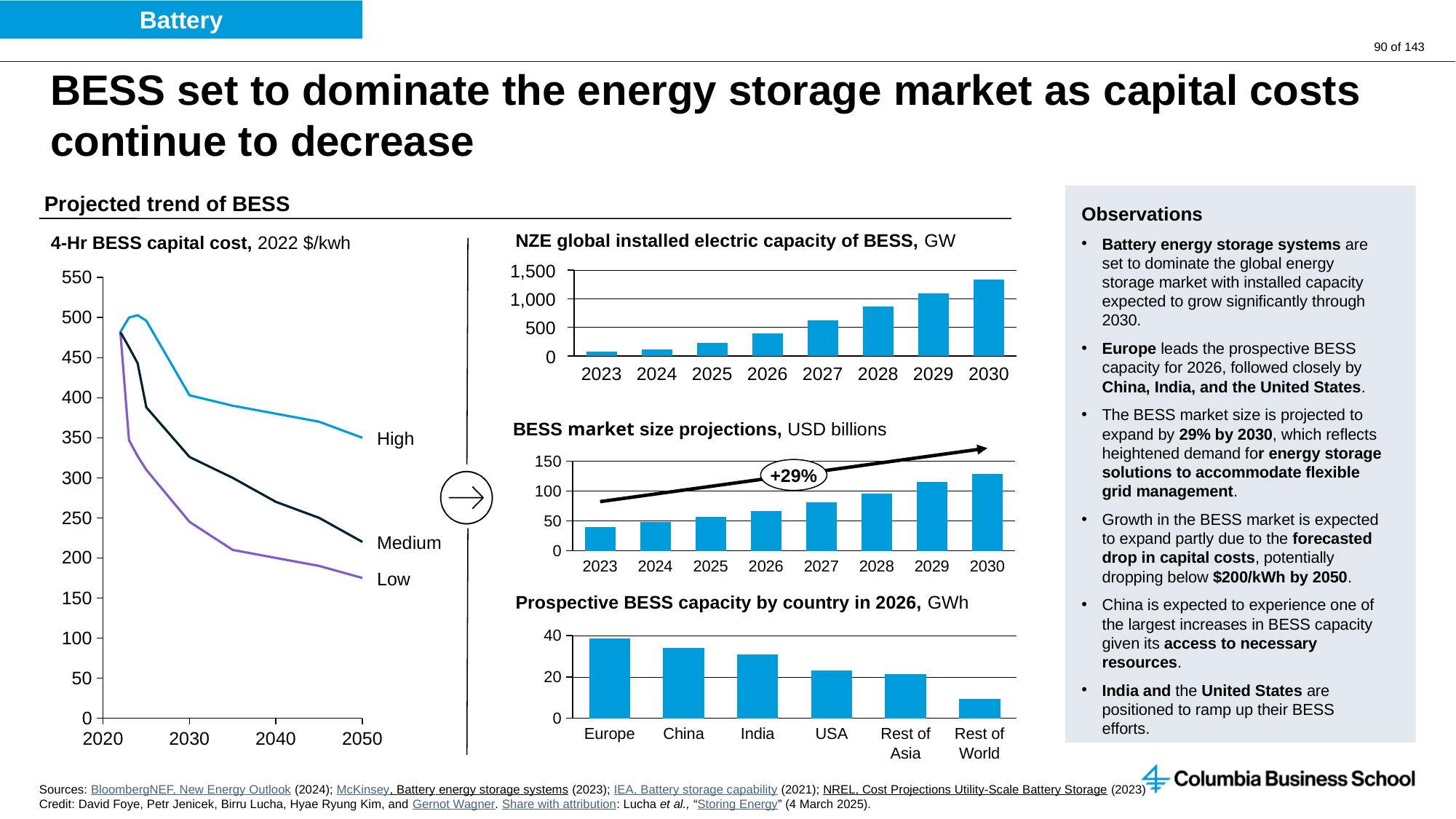
In the 'Prospective BESS capacity by country in 2026' chart, which category has the highest value? Europe In the 'NZE global installed electric capacity of BESS' chart, which year has the lowest value? 2023 In the 'NZE global installed electric capacity of BESS' chart, how many years are shown on the x axis? 8 In the '4-Hr BESS capital cost' chart, how many series does the chart show? 3 In the '4-Hr BESS capital cost' chart, which series has the highest value in 2050? High In the '4-Hr BESS capital cost' chart, do the capital cost lines rise or fall from 2020 to 2050? fall In the '4-Hr BESS capital cost' chart, is the value of the Low line in 2050 greater or less than 200? less In the 'BESS market size projections' chart, is the value for 2023 greater or less than 50? less In the 'BESS market size projections' chart, what growth percentage is annotated on the arrow? +29% In the 'Prospective BESS capacity by country in 2026' chart, is the value for Rest of World greater or less than 20? less What kind of chart is the 'NZE global installed electric capacity of BESS' chart? bar chart